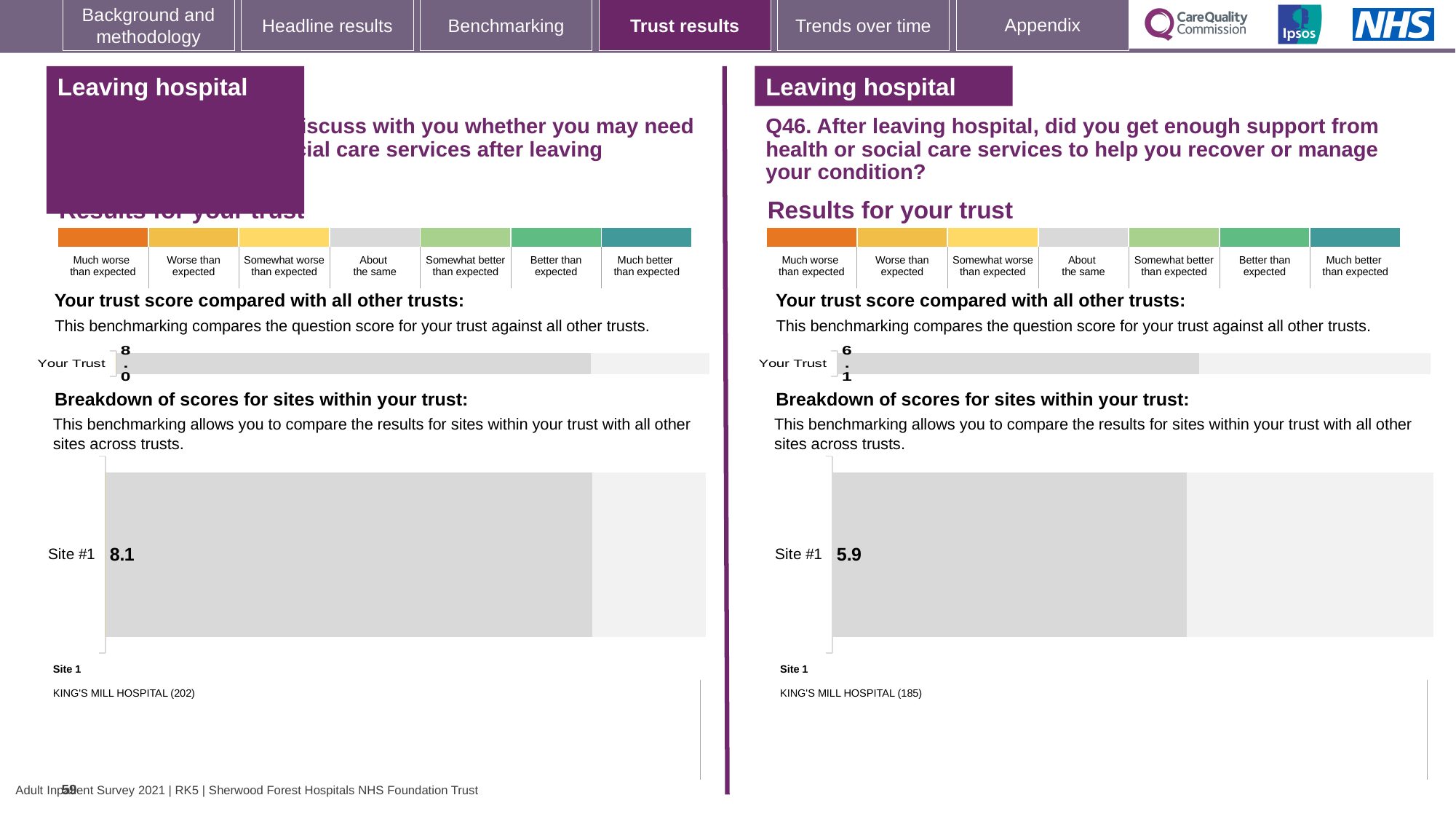
What type of chart is used to show the breakdown of scores for sites within the trust? Bar chart On the right-hand chart for Q46, what is the score shown for Your Trust? 6.1 On the right-hand chart for Q46, how many sites are shown in the breakdown of scores for sites within your trust? 1 On the right-hand chart for Q46, which is larger: the Your Trust score or the Site #1 score? Your Trust How many categories are shown in the colour scale from 'Much worse than expected' to 'Much better than expected' on the right-hand chart? 7 On the left-hand chart, what is the difference between the Site #1 score and the Your Trust score? 0.1 On the right-hand chart for Q46, what is the score shown for Site #1? 5.9 On the right-hand chart for Q46, what is the difference between the Your Trust score and the Site #1 score? 0.2 On the left-hand chart, what is the score shown for Your Trust? 8.0 Which Site #1 score is larger: the one on the left-hand chart or the one on the right-hand chart for Q46? Left-hand chart On the right-hand chart for Q46, which hospital is listed as Site 1? KING'S MILL HOSPITAL (185) On the left-hand chart, what is the score shown for Site #1? 8.1